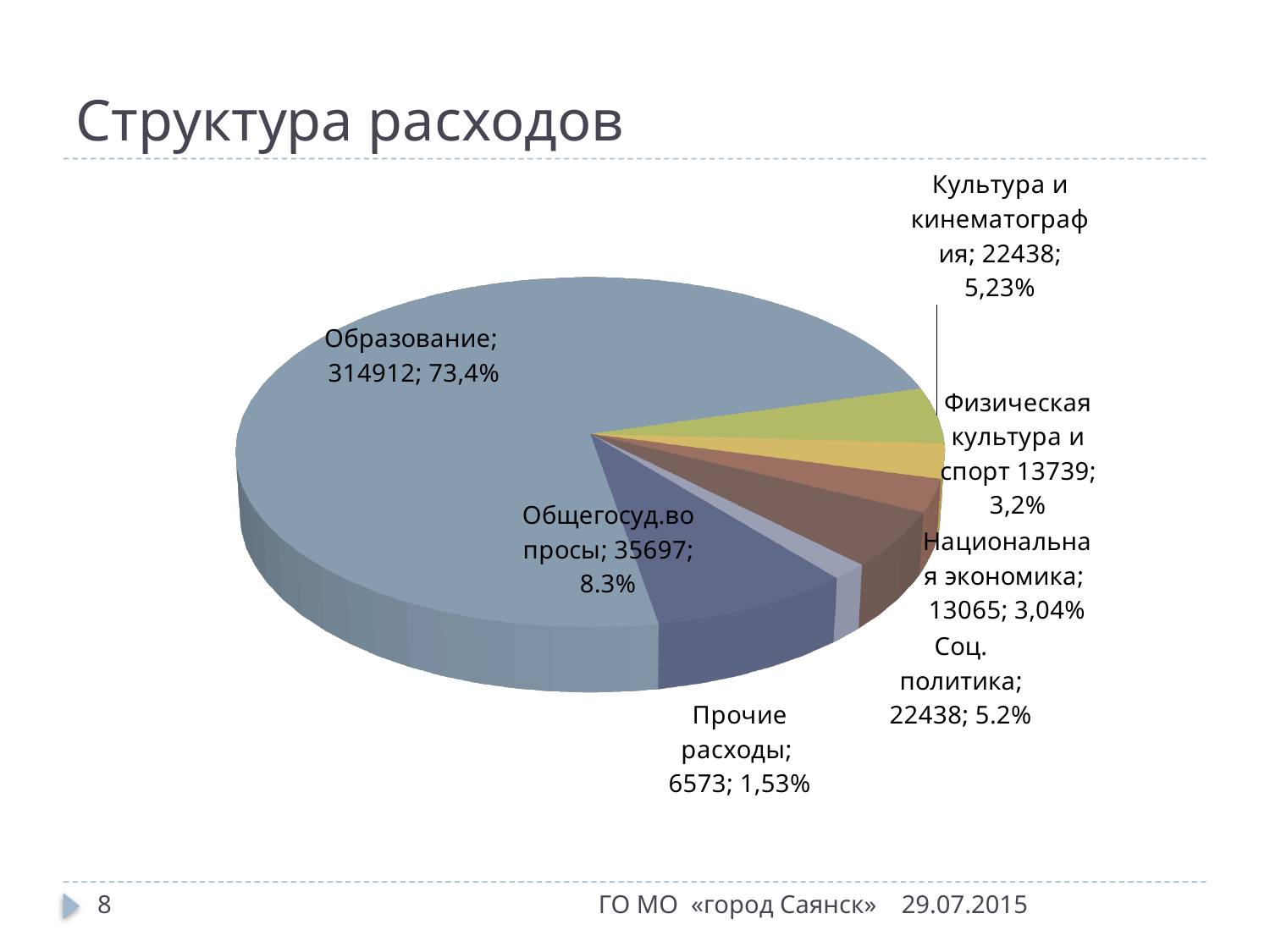
What value is shown for Общегосуд.вопросы? 35697 Which category has the largest slice? Образование What share of the pie does Образование take? 73,4% What value is shown for Национальная экономика? 13065 What kind of chart is shown on the slide? pie chart What is the title of the chart? Структура расходов Which category has the smallest slice? Прочие расходы What value is shown for Образование? 314912 How many slices does the pie chart have? 7 What share of the pie does Прочие расходы take? 1,53% What is the difference between the values for Физическая культура и спорт and Национальная экономика? 674 Which is larger, Общегосуд.вопросы or Соц. политика? Общегосуд.вопросы